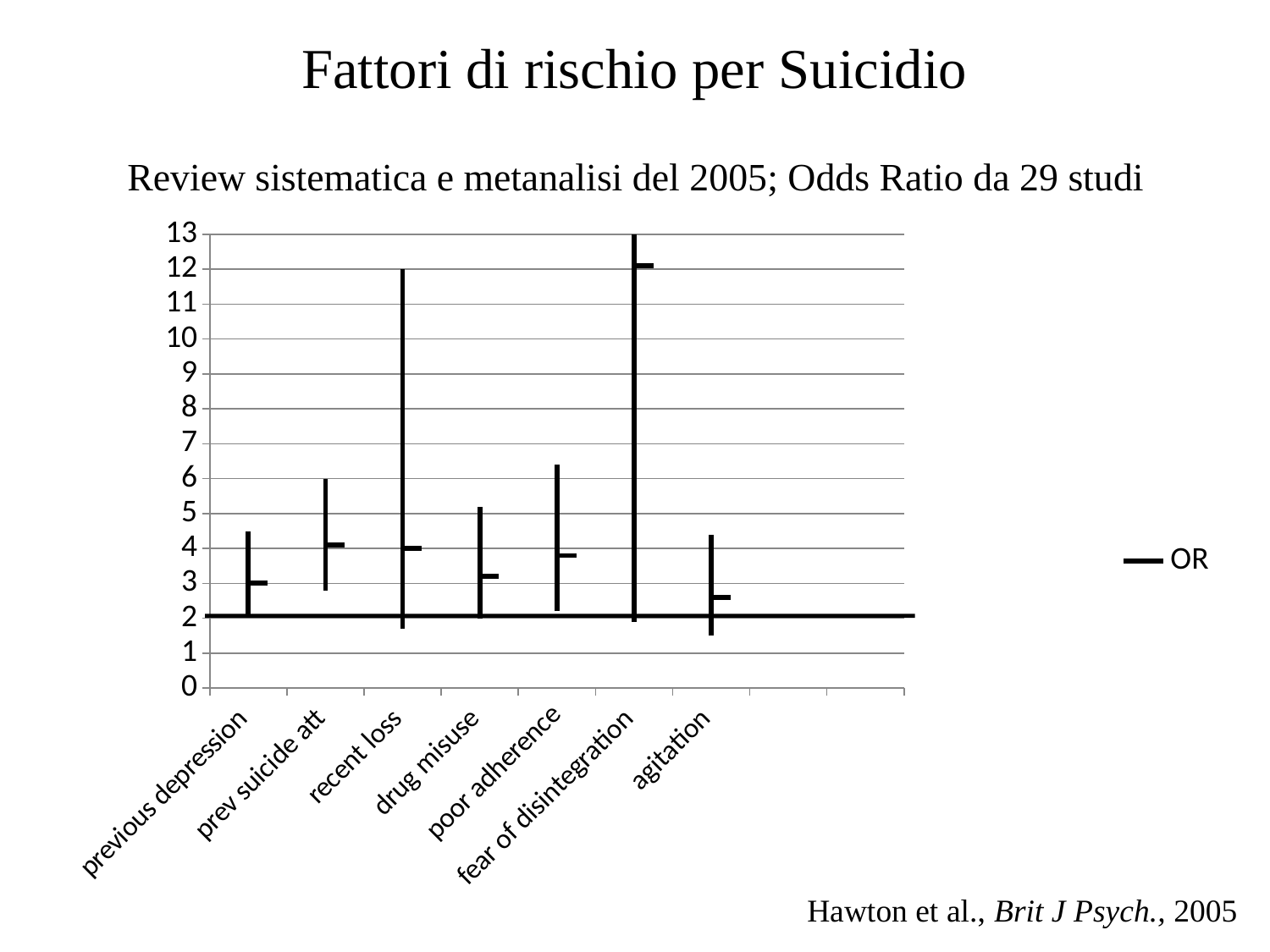
Is the OR value for agitation greater or less than 3? less What is the name of the series shown in the legend? OR Which has a larger OR value, fear of disintegration or recent loss? fear of disintegration How many risk factor categories are labelled on the x axis? 7 Which category has the highest OR value on the chart? fear of disintegration Is the OR value for fear of disintegration greater or less than 10? greater Which has a larger OR value, prev suicide att or agitation? prev suicide att Is the OR value for prev suicide att greater or less than 3? greater How many series does the legend list? 1